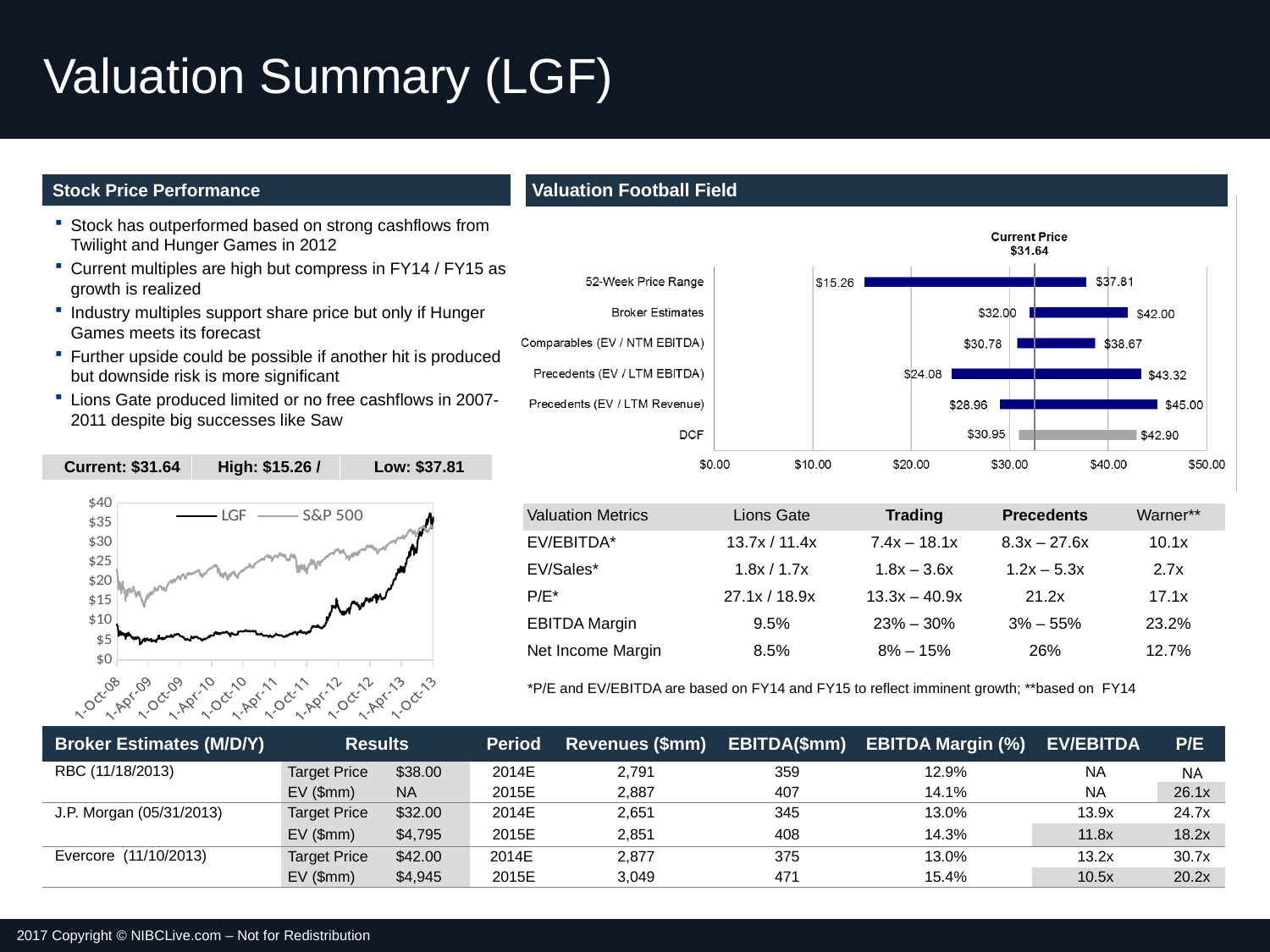
In the Valuation Football Field chart, what is the difference between the high and low ends of the Broker Estimates range? $10.00 In the Valuation Football Field chart, which has the higher upper value: DCF or Comparables (EV / NTM EBITDA)? DCF In the Valuation Football Field chart, what is the low end of the 52-Week Price Range? $15.26 In the Stock Price Performance chart, is the LGF value at 1-Oct-13 greater or less than $30? greater How many series does the legend of the Stock Price Performance chart list? 2 In the Valuation Football Field chart, what is the high end of the Precedents (EV / LTM Revenue) range? $45.00 What kind of chart is the Stock Price Performance chart? Line chart In the Valuation Football Field chart, which category has the lowest low-end value? 52-Week Price Range In the Valuation Football Field chart, which category has the highest upper value? Precedents (EV / LTM Revenue) How many valuation categories are plotted in the Valuation Football Field chart? 6 In the Valuation Football Field chart, what is the low end of the DCF range? $30.95 What current price is marked on the Valuation Football Field chart? $31.64